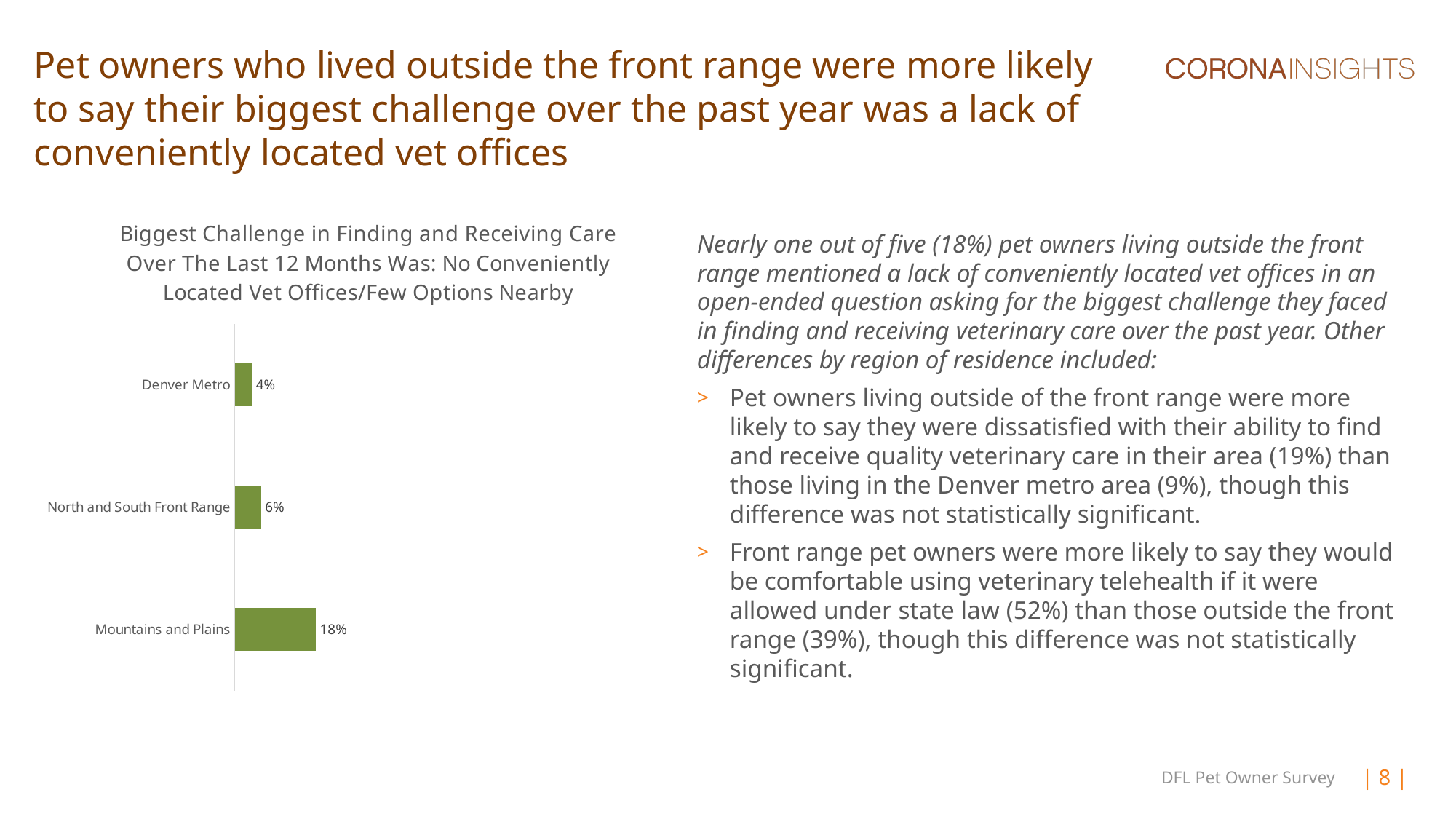
What is the title of the chart? Biggest Challenge in Finding and Receiving Care Over The Last 12 Months Was: No Conveniently Located Vet Offices/Few Options Nearby What is the difference between the values for Mountains and Plains and Denver Metro? 14% What is the value for Denver Metro? 4% What is the value for North and South Front Range? 6% What colour are the bars in the chart? Green What is the value for Mountains and Plains? 18% How many categories are shown in the chart? 3 What is the difference between the values for North and South Front Range and Denver Metro? 2% What kind of chart is shown on the slide? Bar chart Which is larger, the value for North and South Front Range or the value for Denver Metro? North and South Front Range Which category has the lowest value? Denver Metro Which category has the highest value? Mountains and Plains